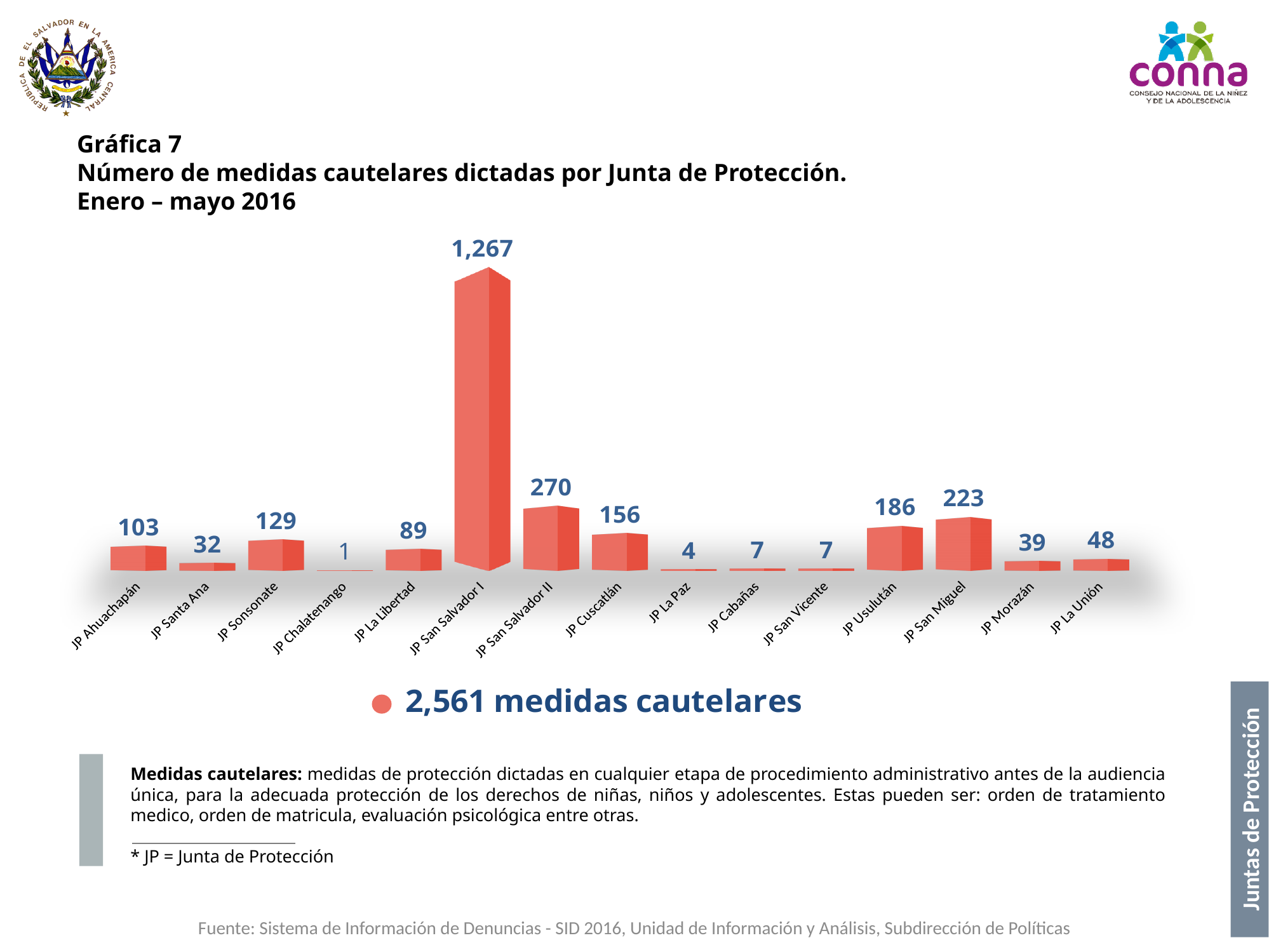
How many series does the legend list? 1 What is the difference between the values for JP Sonsonate and JP Ahuachapán? 26 Which Junta de Protección has the lowest number of medidas cautelares? JP Chalatenango What is the value for JP San Salvador I? 1,267 What is the value for JP Usulután? 186 Which is larger, the value for JP San Miguel or the value for JP Usulután? JP San Miguel Which Junta de Protección has the highest number of medidas cautelares? JP San Salvador I What is the value for JP Chalatenango? 1 What is the difference between the values for JP San Salvador II and JP Cuscatlán? 114 How many Juntas de Protección are shown on the chart? 15 What is the legend entry shown below the chart? 2,561 medidas cautelares What kind of chart is shown on the slide? Bar chart